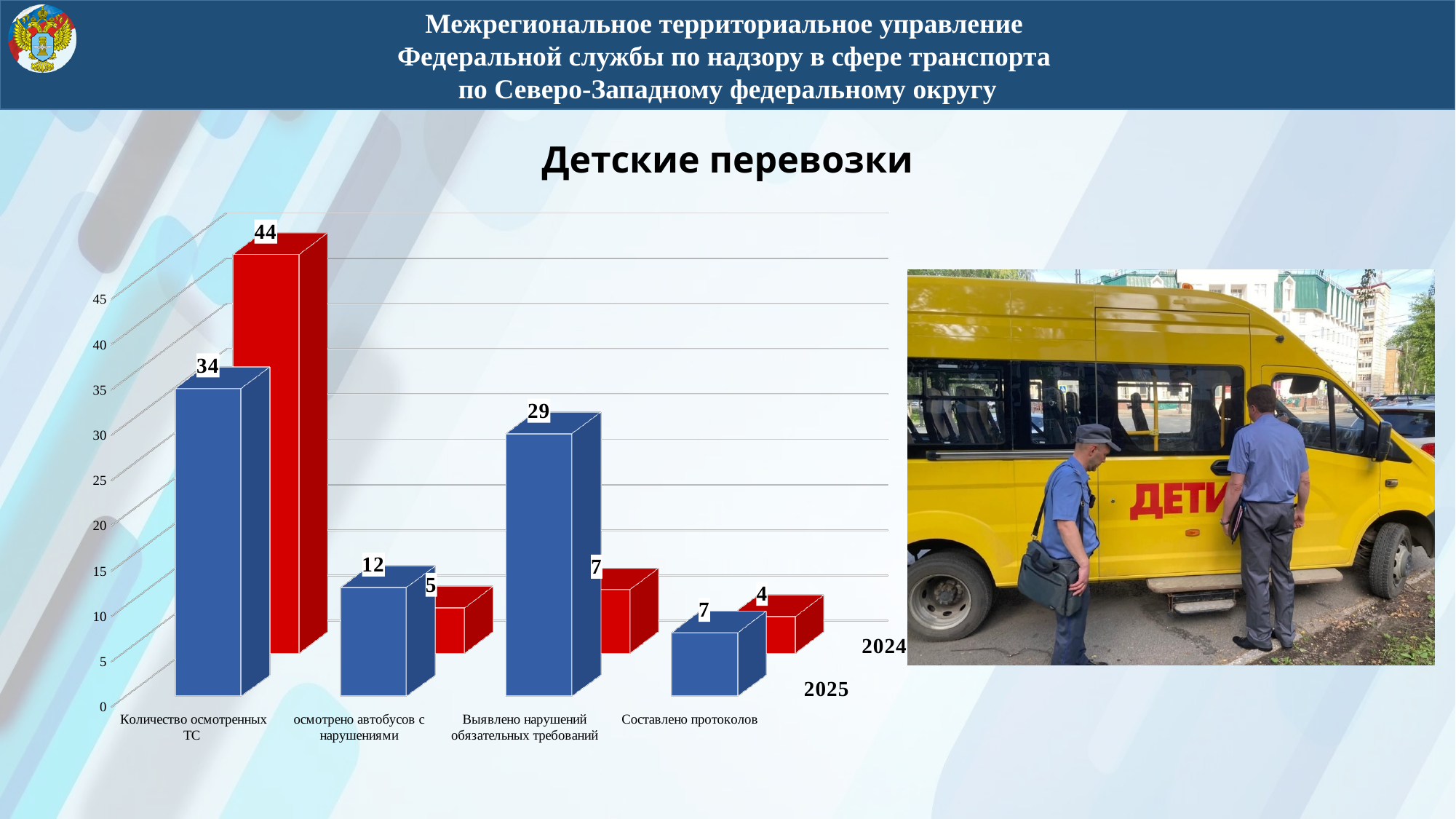
Which is larger for 'осмотрено автобусов с нарушениями': the 2024 value or the 2025 value? 2025 What is the value for 'Количество осмотренных ТС' in the 2025 series? 34 Which category has the highest value in the 2024 series? Количество осмотренных ТС Which category has the lowest value in the 2025 series? Составлено протоколов What type of chart is shown on the slide? bar chart How many categories are shown on the x axis of the chart? 4 What is the difference between the 2024 and 2025 values for 'Количество осмотренных ТС'? 10 What is the value for 'Выявлено нарушений обязательных требований' in the 2025 series? 29 What is the value for 'Составлено протоколов' in the 2024 series? 4 What is the title of the chart on the slide? Детские перевозки How many data series does the chart show? 2 What is the value for 'Количество осмотренных ТС' in the 2024 series? 44